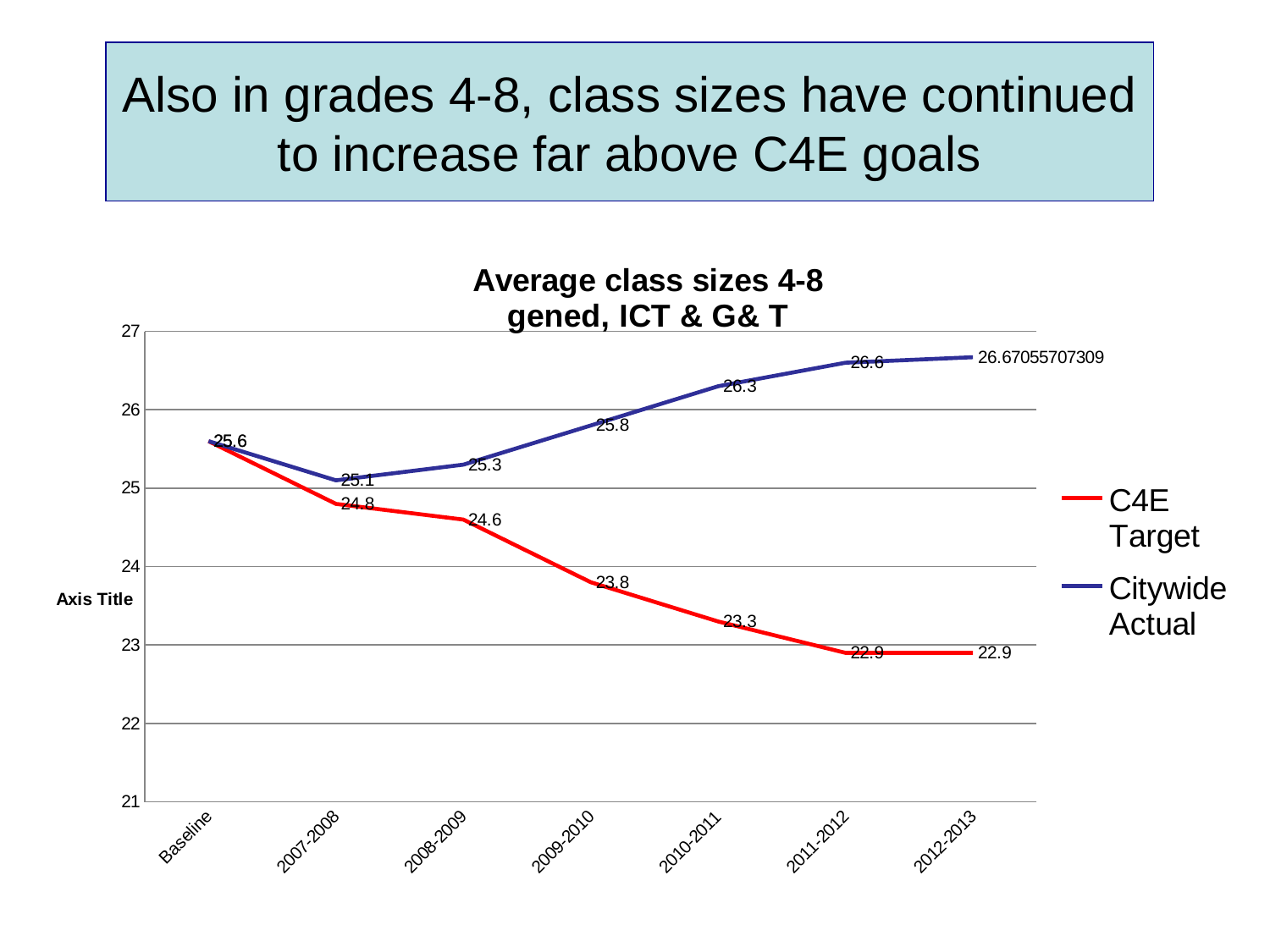
What is the difference between the Citywide Actual and C4E Target values for 2011-2012? 3.7 What is the title of the chart? Average class sizes 4-8 gened, ICT & G& T What is the Citywide Actual value for 2010-2011? 26.3 What is the C4E Target value for 2011-2012? 22.9 Which is larger in 2008-2009, the C4E Target value or the Citywide Actual value? Citywide Actual Does the C4E Target series rise or fall from Baseline to 2012-2013? fall What is the Citywide Actual value for 2012-2013? 26.67055707309 In which category is the Citywide Actual value lowest? 2007-2008 How many categories are shown on the x axis? 7 How many series does the legend list? 2 What is the C4E Target value for 2009-2010? 23.8 What kind of chart is shown on the slide? line chart